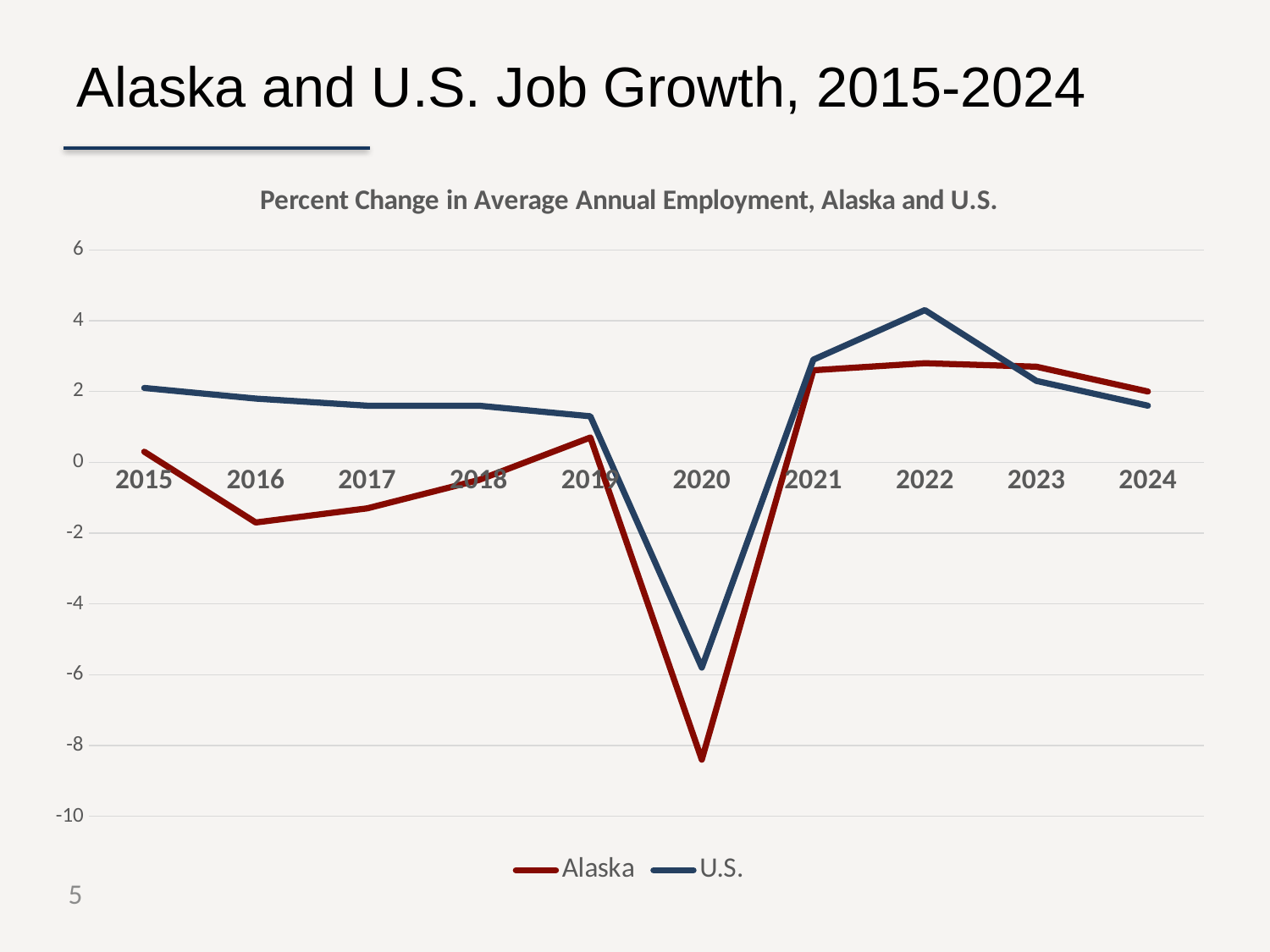
In 2016, which series has the higher value, Alaska or U.S.? U.S. In 2020, which series has the lower value, Alaska or U.S.? Alaska In which year does the U.S. line reach its highest value? 2022 Is the value for Alaska in 2020 greater or less than -6? less How many series does the legend list? 2 Is the value for U.S. in 2020 greater or less than -4? less What is the title of the chart? Percent Change in Average Annual Employment, Alaska and U.S. What kind of chart is shown on the slide? line chart How many years are plotted along the x axis? 10 In which year does the Alaska line reach its lowest value? 2020 Does the Alaska line rise or fall from 2016 to 2019? rise Is the value for U.S. in 2022 greater or less than 2? greater